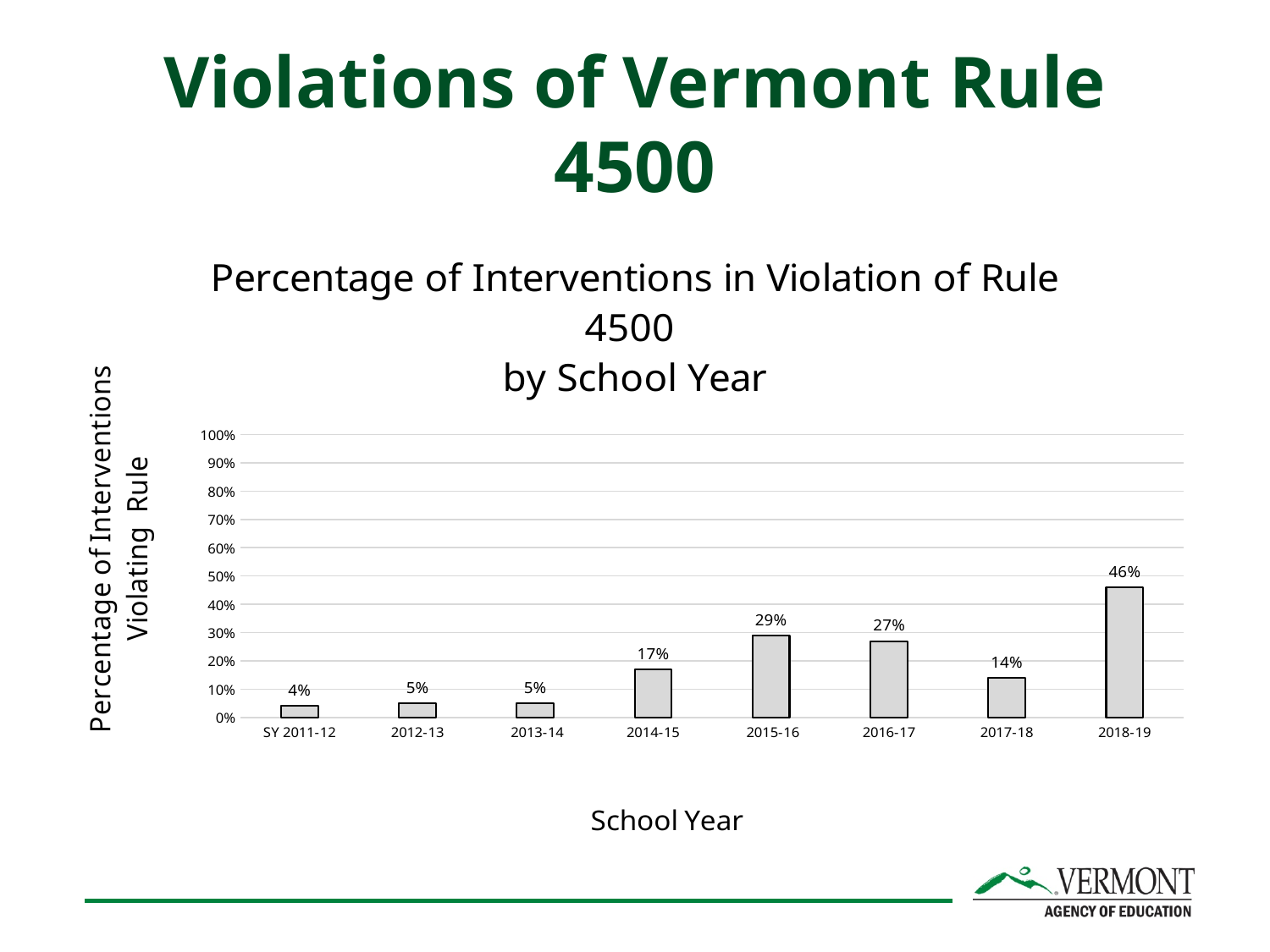
Which school year has the lowest percentage of interventions in violation of Rule 4500? SY 2011-12 How many school years are shown on the x axis? 8 What is the difference between the values for 2014-15 and 2013-14? 12% Is the value for 2014-15 greater or less than 20%? less What is the difference between the percentages for 2018-19 and 2017-18? 32% What kind of chart is shown on the slide? bar chart Which is larger, the value for 2015-16 or the value for 2016-17? 2015-16 Which school year has the highest percentage of interventions in violation of Rule 4500? 2018-19 What percentage of interventions violated Rule 4500 in 2018-19? 46% What percentage is shown for 2015-16? 29% What is the value shown for SY 2011-12? 4% What is the label of the x axis? School Year